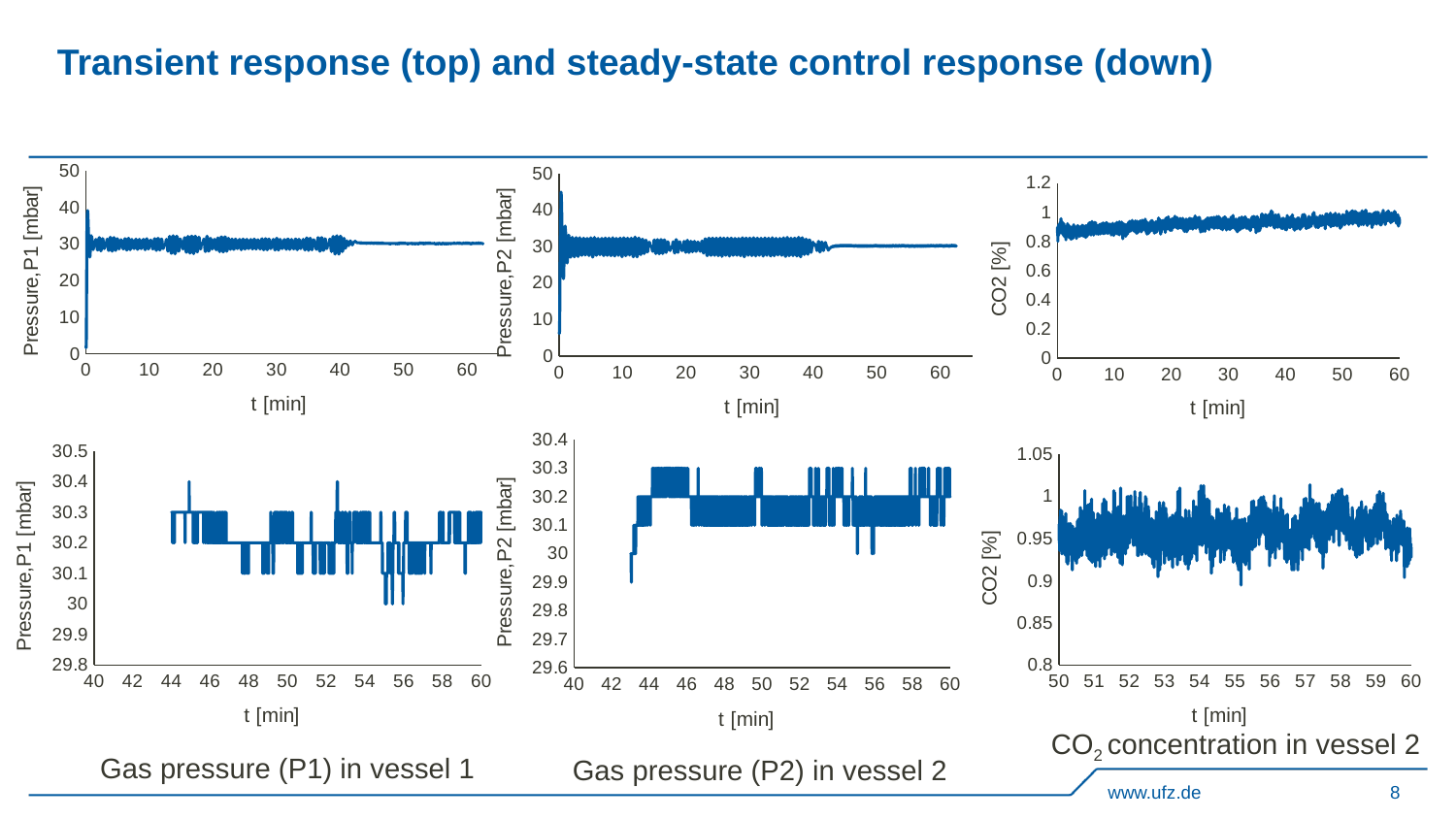
How many charts are shown on the slide? 6 In the bottom-left chart (Pressure, P1 [mbar], 40 to 60 min), is the value at t = 48 min greater or less than 30.5? less In the bottom-right chart (CO2 [%], 50 to 60 min), is the value at t = 52 min greater or less than 1.05? less In the top-right chart (CO2 [%], 0 to 60 min), is the value at t = 30 min greater or less than 0.6? greater In the top-right chart (CO2 [%], 0 to 60 min), do the values generally rise or fall from t = 0 to t = 60 min? rise What is the y-axis label of the top-left chart? Pressure,P1 [mbar] What caption is printed below the bottom-middle chart? Gas pressure (P2) in vessel 2 What kind of chart is the top-left chart (Pressure, P1 vs t)? line chart